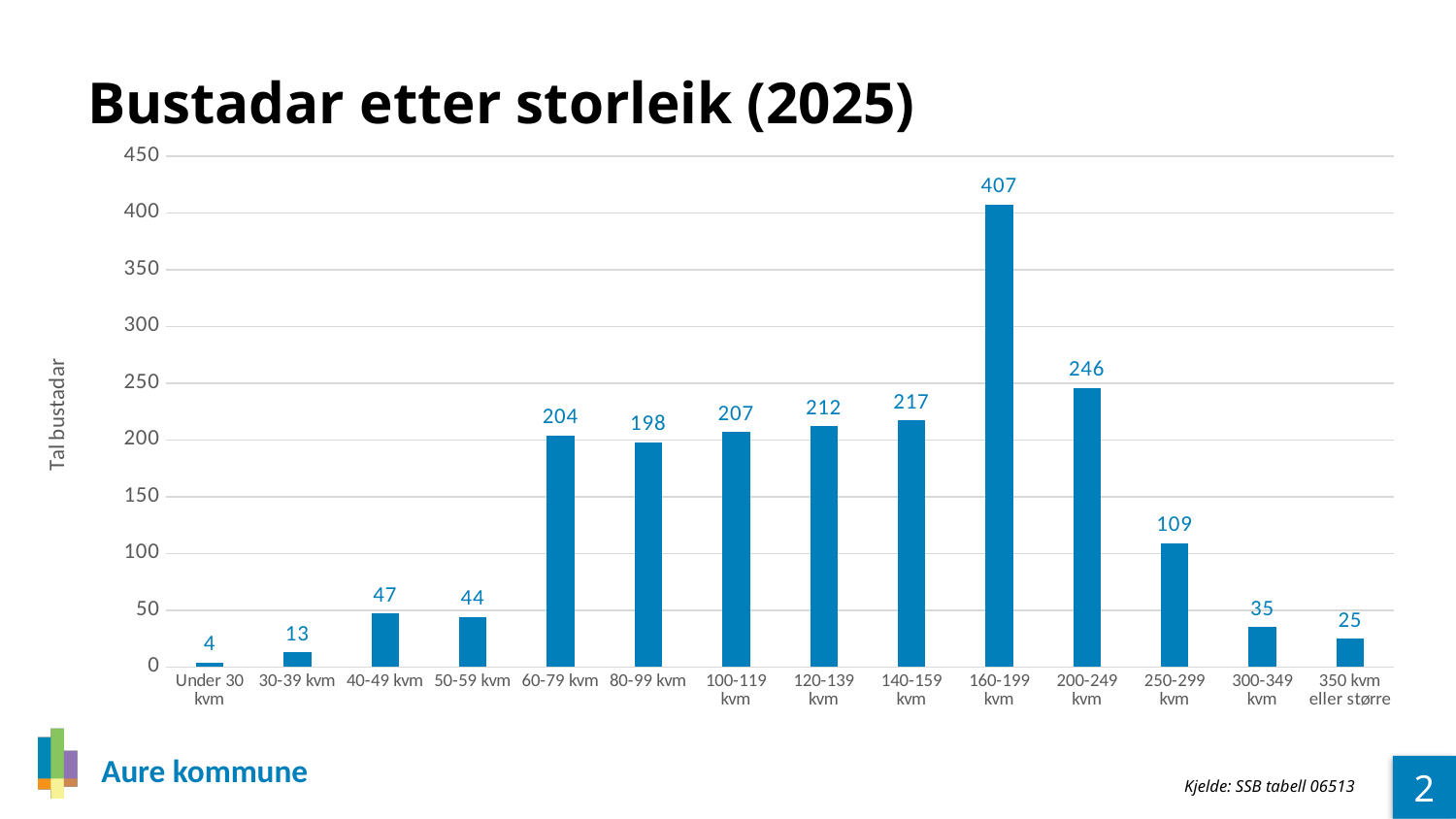
Which category has the highest value? 160-199 kvm What is the value for 350 kvm eller større? 25 What is the value for 160-199 kvm? 407 Is the value for 250-299 kvm greater or less than 150? less What is the title of the chart? Bustadar etter storleik (2025) What is the difference between the values for 160-199 kvm and 200-249 kvm? 161 What kind of chart is this? bar chart How many categories are shown on the x axis? 14 What is the value for 60-79 kvm? 204 What is the label of the y axis? Tal bustadar Which is larger, the value for 80-99 kvm or the value for 100-119 kvm? 100-119 kvm Which category has the lowest value? Under 30 kvm